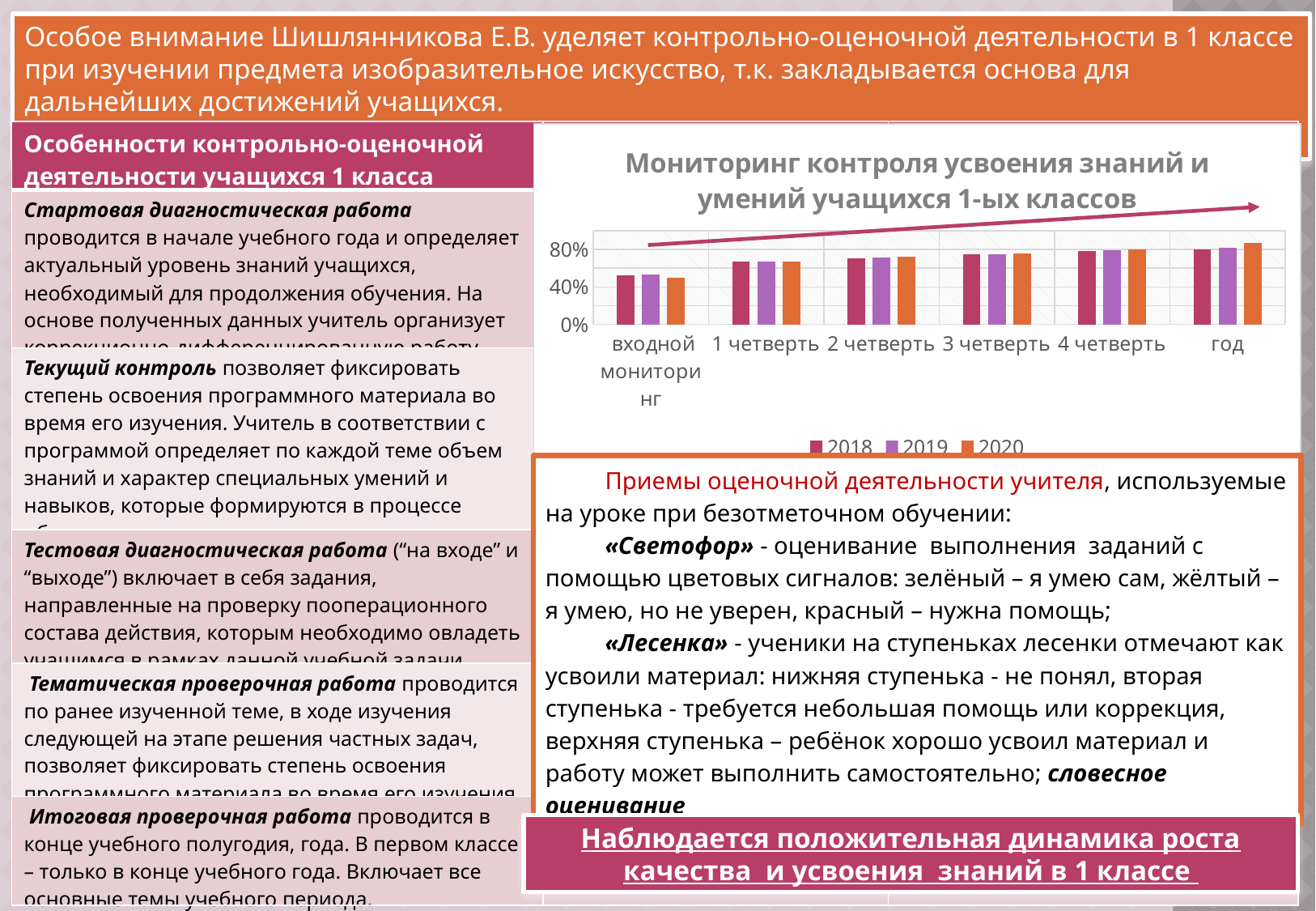
Is the 2018 value for входной мониторинг greater or less than 80%? less Is the 2020 value for 1 четверть greater or less than 80%? less How many series does the chart legend list? 3 Which is larger for the category год: the 2018 value or the 2020 value? 2020 What is the title of the chart? Мониторинг контроля усвоения знаний и умений учащихся 1-ых классов Which years are listed in the chart legend? 2018, 2019, 2020 Do the values rise or fall from входной мониторинг to год? rise How many categories are shown along the x axis of the chart? 6 What kind of chart is shown on the slide? bar chart Is the 2018 value for входной мониторинг greater or less than 40%? greater Which category has the lowest values across all three series? входной мониторинг